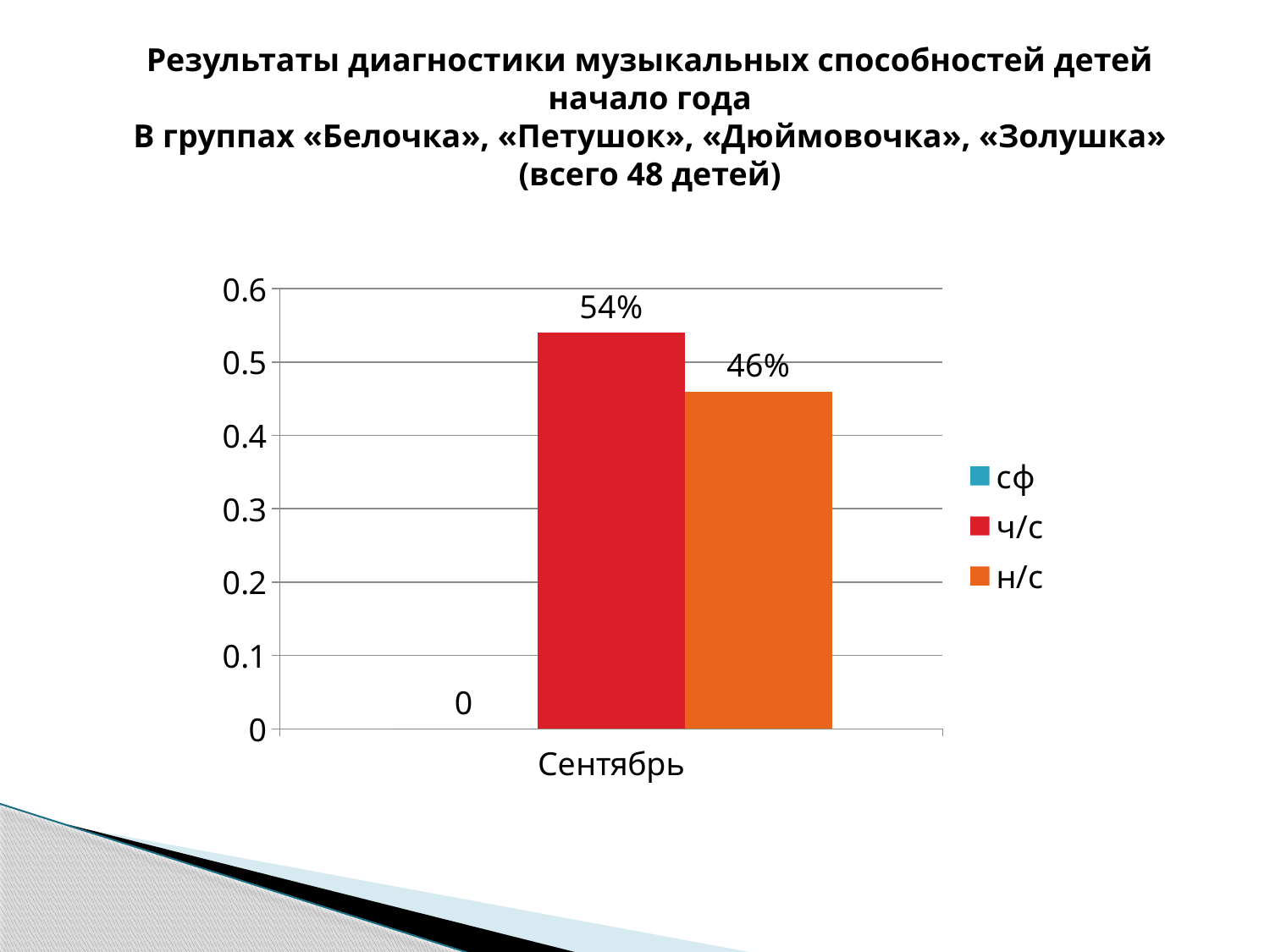
Which series has the highest value in Сентябрь? ч/с What is the value for the н/с series in Сентябрь? 46% Which is larger in Сентябрь, the ч/с value or the н/с value? ч/с Which series has the lowest value in Сентябрь? сф What is the value for the ч/с series in Сентябрь? 54% What is the difference between the ч/с and н/с values in Сентябрь? 8% How many series does the legend list? 3 Is the value for н/с in Сентябрь greater or less than 0.5? less What is the value for the сф series in Сентябрь? 0 How many categories are shown on the x axis? 1 What kind of chart is shown on the slide? bar chart What colour is the bar for the н/с series? orange